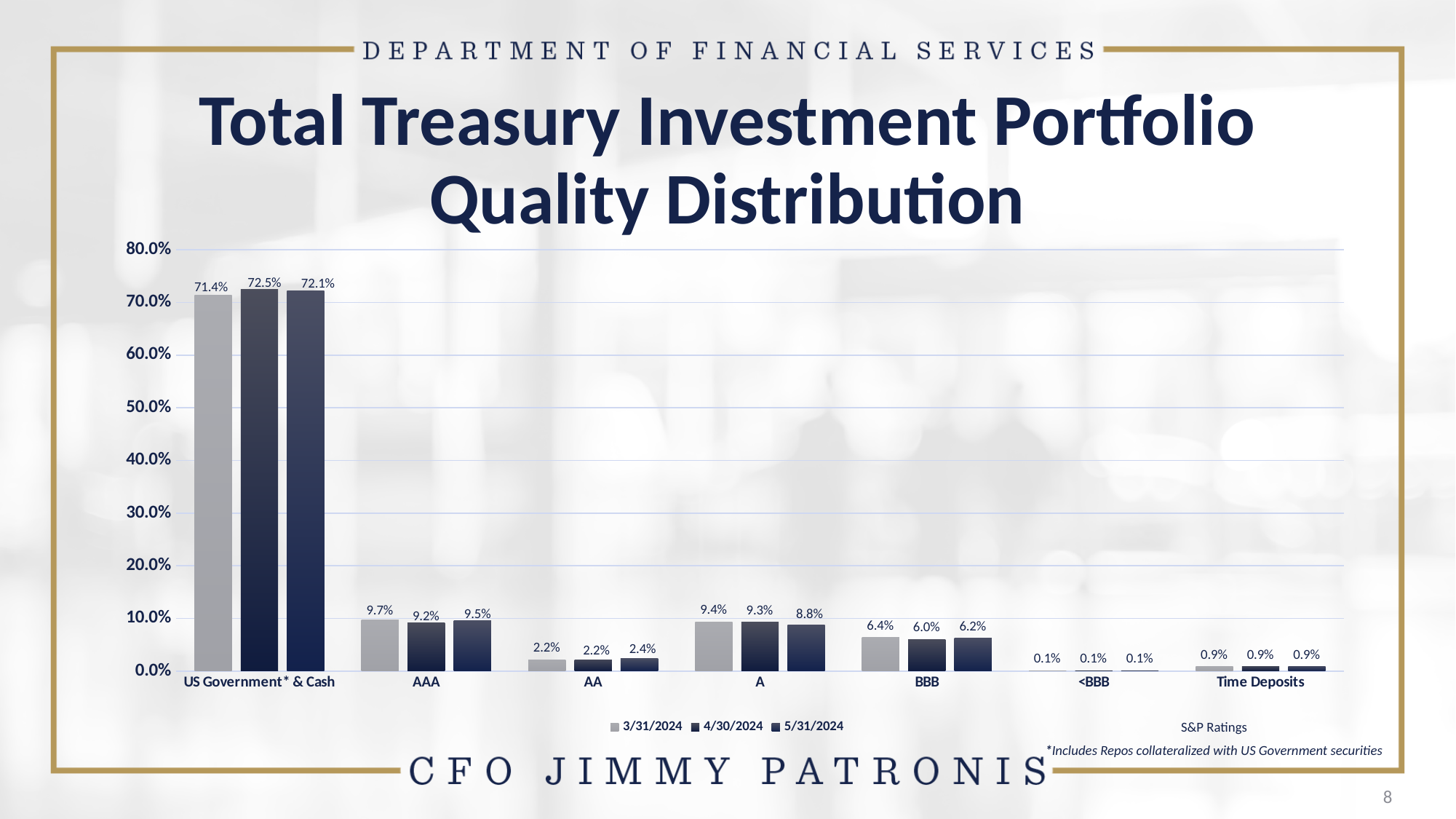
What is the value for Time Deposits in the 3/31/2024 series? 0.9% What kind of chart is shown on the slide? Bar chart What is the title of the chart? Total Treasury Investment Portfolio Quality Distribution Which is larger for the A category: the 3/31/2024 value or the 5/31/2024 value? 3/31/2024 What is the value for BBB in the 4/30/2024 series? 6.0% What is the difference between the 4/30/2024 and 3/31/2024 values for US Government* & Cash? 1.1% How many series does the legend list? 3 What is the value for US Government* & Cash in the 3/31/2024 series? 71.4% Which category has the lowest value in the 5/31/2024 series? <BBB What is the value for AAA in the 5/31/2024 series? 9.5% How many categories are shown on the x axis? 7 Which category has the highest value in the 4/30/2024 series? US Government* & Cash